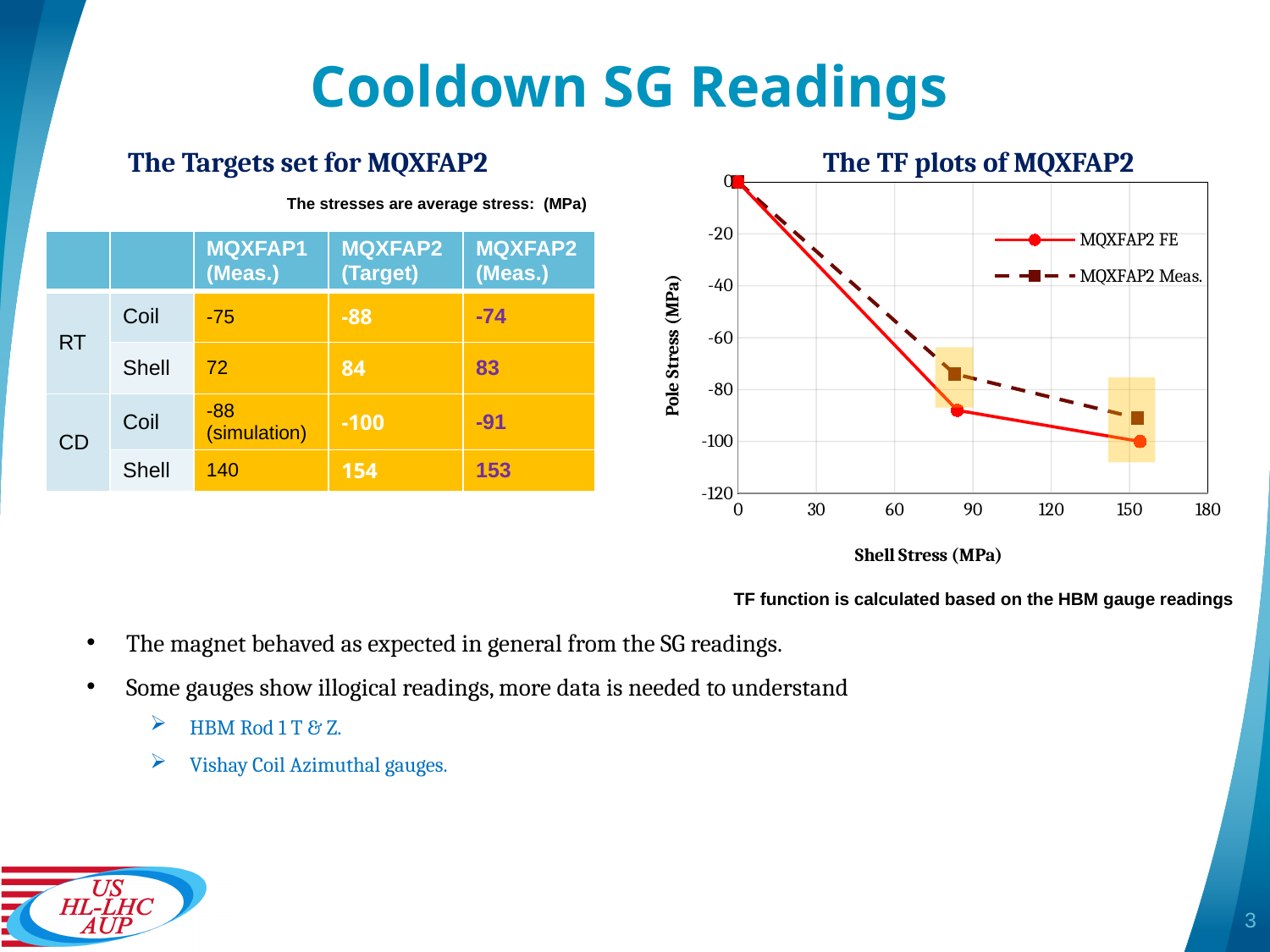
In "The TF plots of MQXFAP2", is the pole stress of the MQXFAP2 FE series at its last point (shell stress near 150 MPa) greater or less than -90? less In "The TF plots of MQXFAP2", at the last point (shell stress near 150 MPa), which series has the lower pole stress, MQXFAP2 FE or MQXFAP2 Meas.? MQXFAP2 FE In "The TF plots of MQXFAP2", is the pole stress of the MQXFAP2 Meas. series at its last point (shell stress near 150 MPa) greater or less than -80? less In "The TF plots of MQXFAP2", how many data points are plotted for the MQXFAP2 FE series? 3 In "The TF plots of MQXFAP2", at the middle point (shell stress near 90 MPa), which series has the higher pole stress, MQXFAP2 FE or MQXFAP2 Meas.? MQXFAP2 Meas. In "The TF plots of MQXFAP2", is the pole stress of the MQXFAP2 Meas. series at its middle point (shell stress near 90 MPa) greater or less than -80? greater In "The TF plots of MQXFAP2", which series is drawn with a dashed line? MQXFAP2 Meas. What kind of chart is "The TF plots of MQXFAP2"? Line chart What is the x-axis title of "The TF plots of MQXFAP2"? Shell Stress (MPa) In "The TF plots of MQXFAP2", does pole stress rise or fall as shell stress increases? Fall How many series does the legend of "The TF plots of MQXFAP2" list? 2